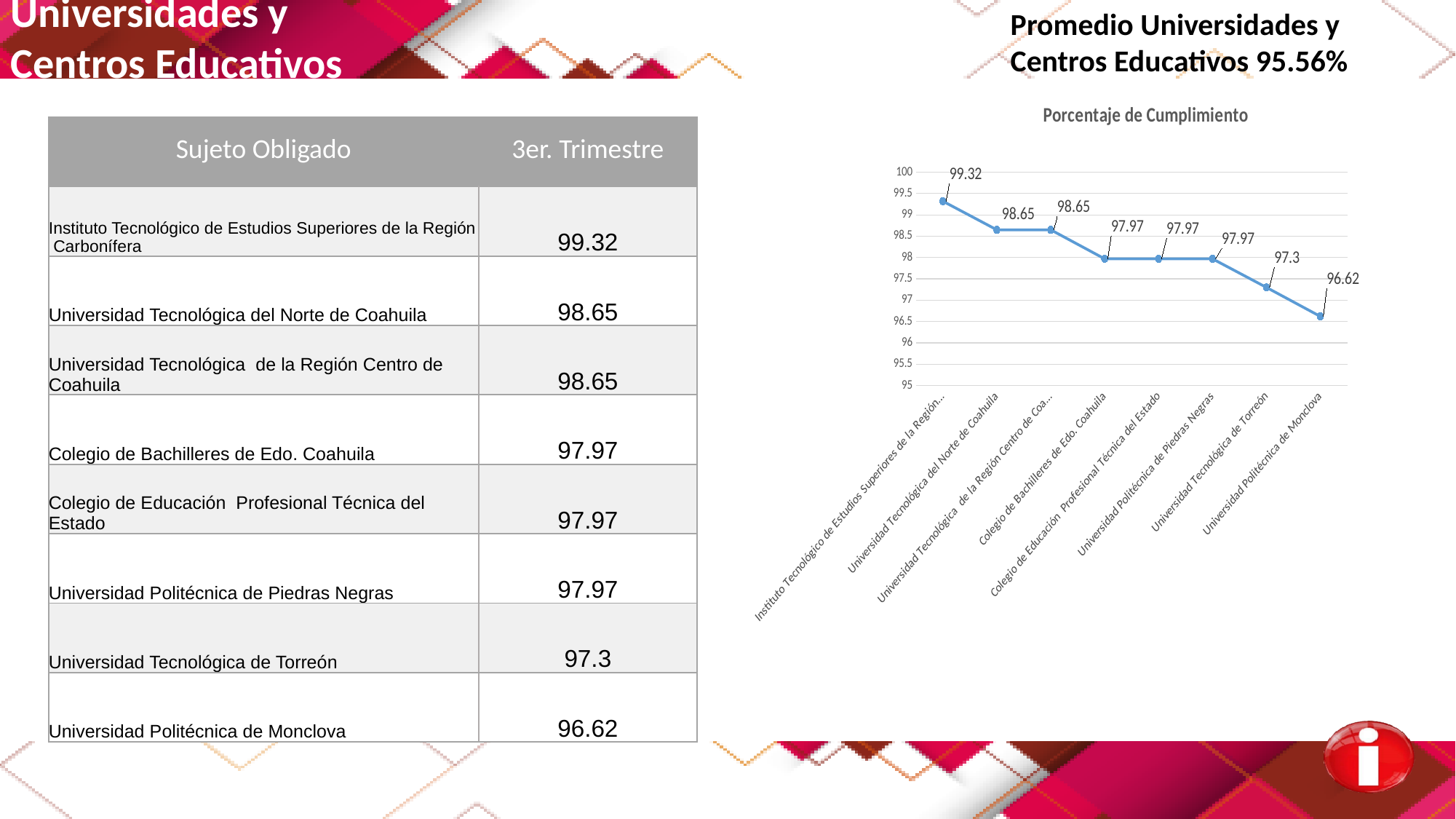
What is the title of the chart? Porcentaje de Cumplimiento Do the values in the chart generally rise or fall from left to right along the x axis? Fall Which category has the highest value in the chart? Instituto Tecnológico de Estudios Superiores de la Región Carbonífera What is the value for Universidad Politécnica de Monclova in the chart? 96.62 Which category has the lowest value in the chart? Universidad Politécnica de Monclova What is the difference between the values for Universidad Tecnológica de Torreón and Universidad Politécnica de Monclova? 0.68 How many data points are plotted in the chart? 8 What type of chart is shown on the slide? Line chart Which is larger, the value for Universidad Politécnica de Piedras Negras or the value for Universidad Tecnológica de Torreón? Universidad Politécnica de Piedras Negras What is the value for Universidad Tecnológica del Norte de Coahuila in the chart? 98.65 What is the value for Colegio de Bachilleres de Edo. Coahuila in the chart? 97.97 What is the value for Universidad Tecnológica de Torreón in the chart? 97.3